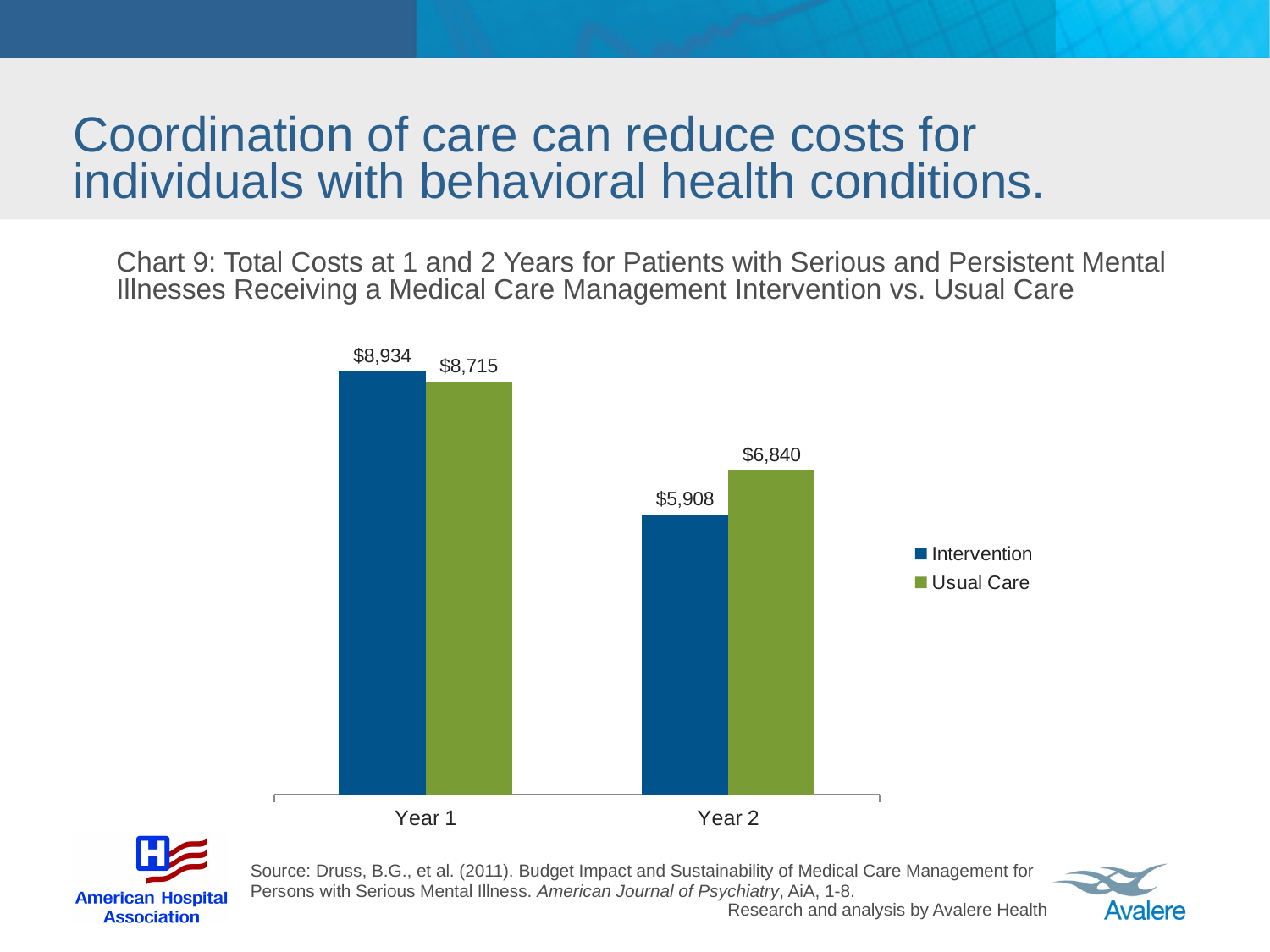
What is the Usual Care cost in Year 1? $8,715 Does the Intervention cost rise or fall from Year 1 to Year 2? Fall What is the Intervention cost in Year 2? $5,908 What is the difference between the Usual Care and Intervention costs in Year 2? $932 Which bar shows the highest cost on the chart? Intervention, Year 1 What is the Usual Care cost in Year 2? $6,840 In Year 2, which is larger: the Intervention cost or the Usual Care cost? Usual Care How many series does the legend list? 2 Which bar shows the lowest cost on the chart? Intervention, Year 2 What kind of chart is shown on the slide? Bar chart What is the difference between the Intervention and Usual Care costs in Year 1? $219 What is the Intervention cost in Year 1? $8,934